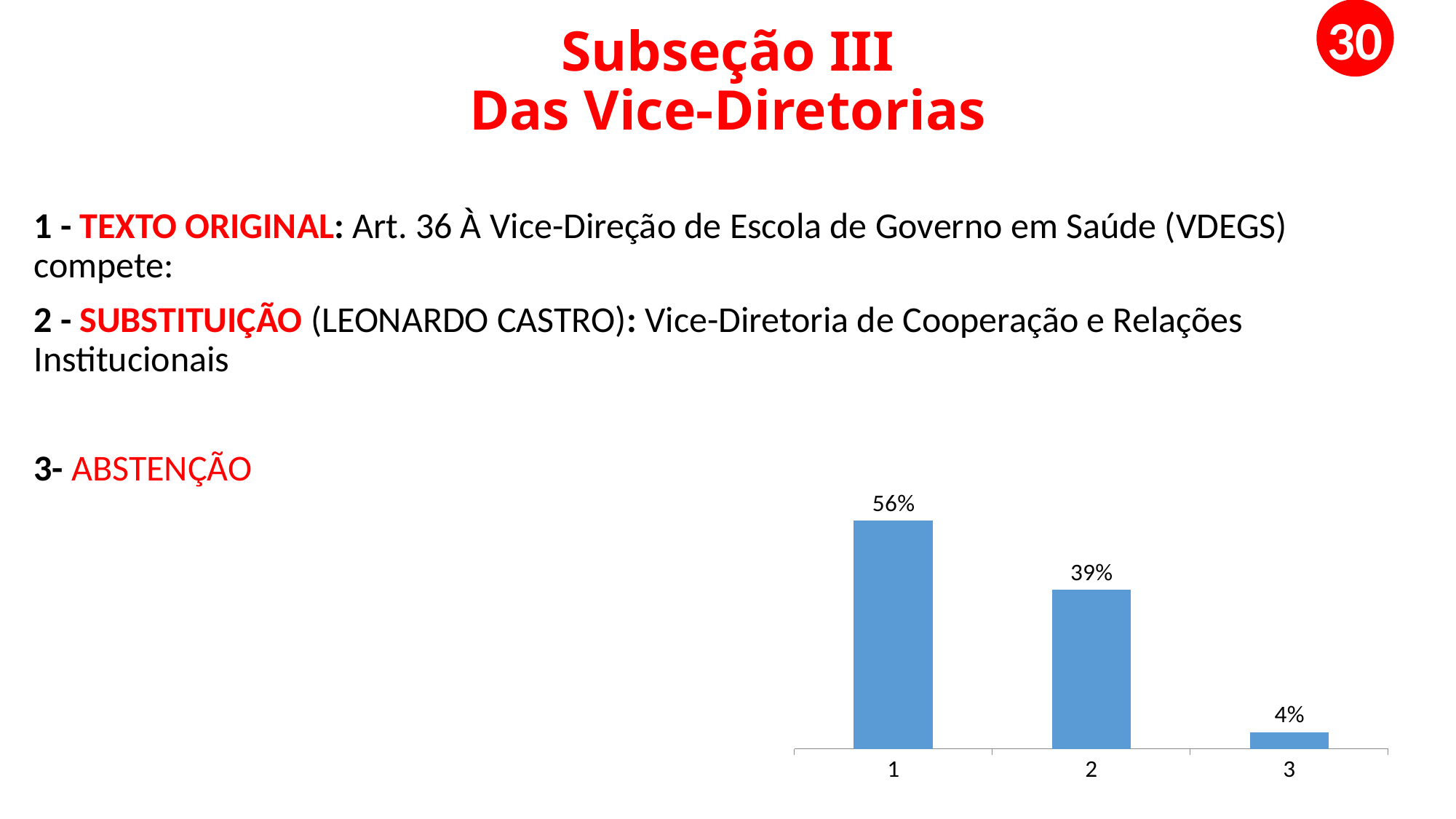
Which category has the lowest value in the chart? 3 How many categories are shown on the x axis of the chart? 3 What colour are the bars in the chart? blue What kind of chart is shown on the slide? bar chart Which category has the highest value in the chart? 1 What is the difference between the values for category 2 and category 3? 35% What is the difference between the values for category 1 and category 2? 17% What is the value shown for category 2 in the chart? 39% What is the value shown for category 3 in the chart? 4% Which is larger, the value for category 2 or the value for category 3? 2 Do the values rise or fall from category 1 to category 3? fall What is the value shown for category 1 in the chart? 56%